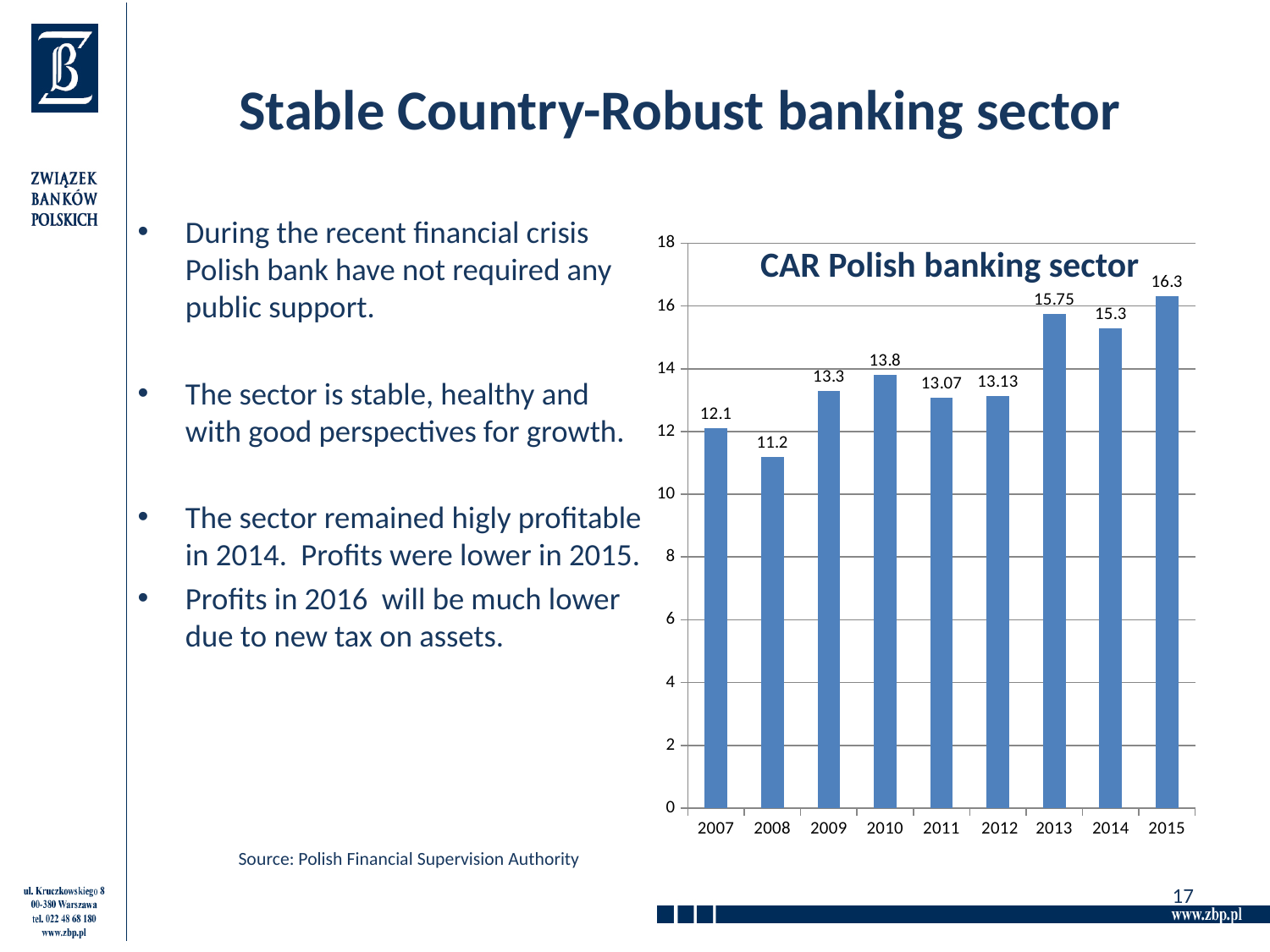
How many years are shown on the x axis of the chart? 9 What is the difference between the CAR values for 2013 and 2014? 0.45 Which year has the highest CAR value? 2015 What is the CAR value for 2013? 15.75 What is the difference between the CAR values for 2015 and 2008? 5.1 What is the title of the chart? CAR Polish banking sector What is the CAR value for 2011? 13.07 Which year has the lowest CAR value? 2008 What is the CAR value for 2007? 12.1 What kind of chart is shown on the slide? bar chart Which is larger, the CAR value for 2010 or for 2012? 2010 Is the CAR value for 2014 greater or less than 14? greater